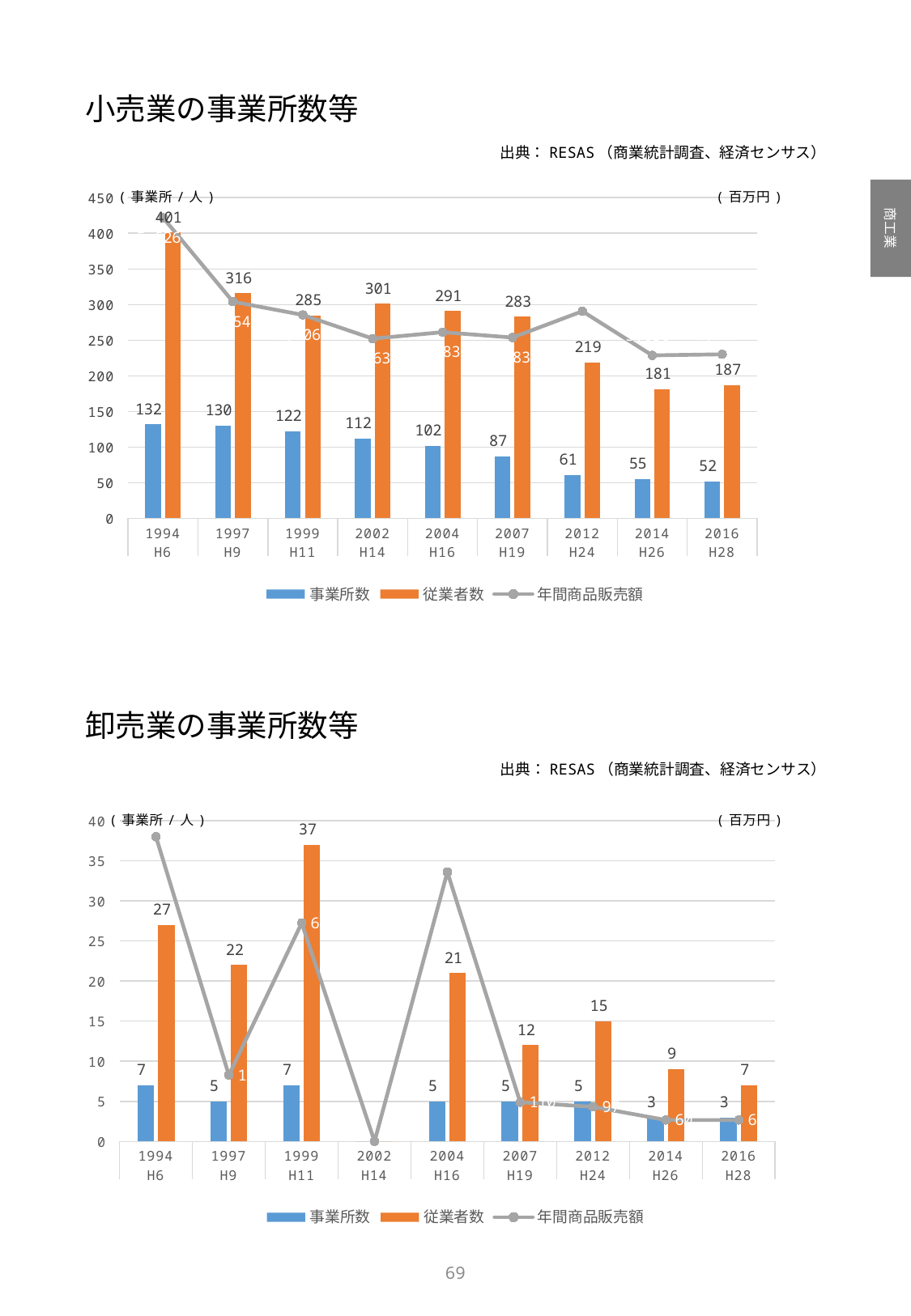
In the 小売業の事業所数等 chart, which year has the highest 従業者数? 1994 (H6) In the 小売業の事業所数等 chart, how many series does the legend list? 3 In the 小売業の事業所数等 chart, what is the difference between the 従業者数 values for 1994 (H6) and 2016 (H28)? 214 In the 小売業の事業所数等 chart, what is the 事業所数 value for 1994 (H6)? 132 In the 卸売業の事業所数等 chart, which year has the highest 従業者数? 1999 (H11) In the 卸売業の事業所数等 chart, how many year categories are shown on the x axis? 9 In the 卸売業の事業所数等 chart, what is the 従業者数 value for 1999 (H11)? 37 In the 卸売業の事業所数等 chart, what is the difference between the 従業者数 values for 1994 (H6) and 1997 (H9)? 5 In the 小売業の事業所数等 chart, which year has the lowest 事業所数? 2016 (H28) In the 卸売業の事業所数等 chart, which is larger, the 従業者数 for 2007 (H19) or for 2012 (H24)? 2012 (H24) In the 小売業の事業所数等 chart, does 事業所数 rise or fall from 1994 to 2016? fall In the 小売業の事業所数等 chart, what is the 従業者数 value for 2012 (H24)? 219